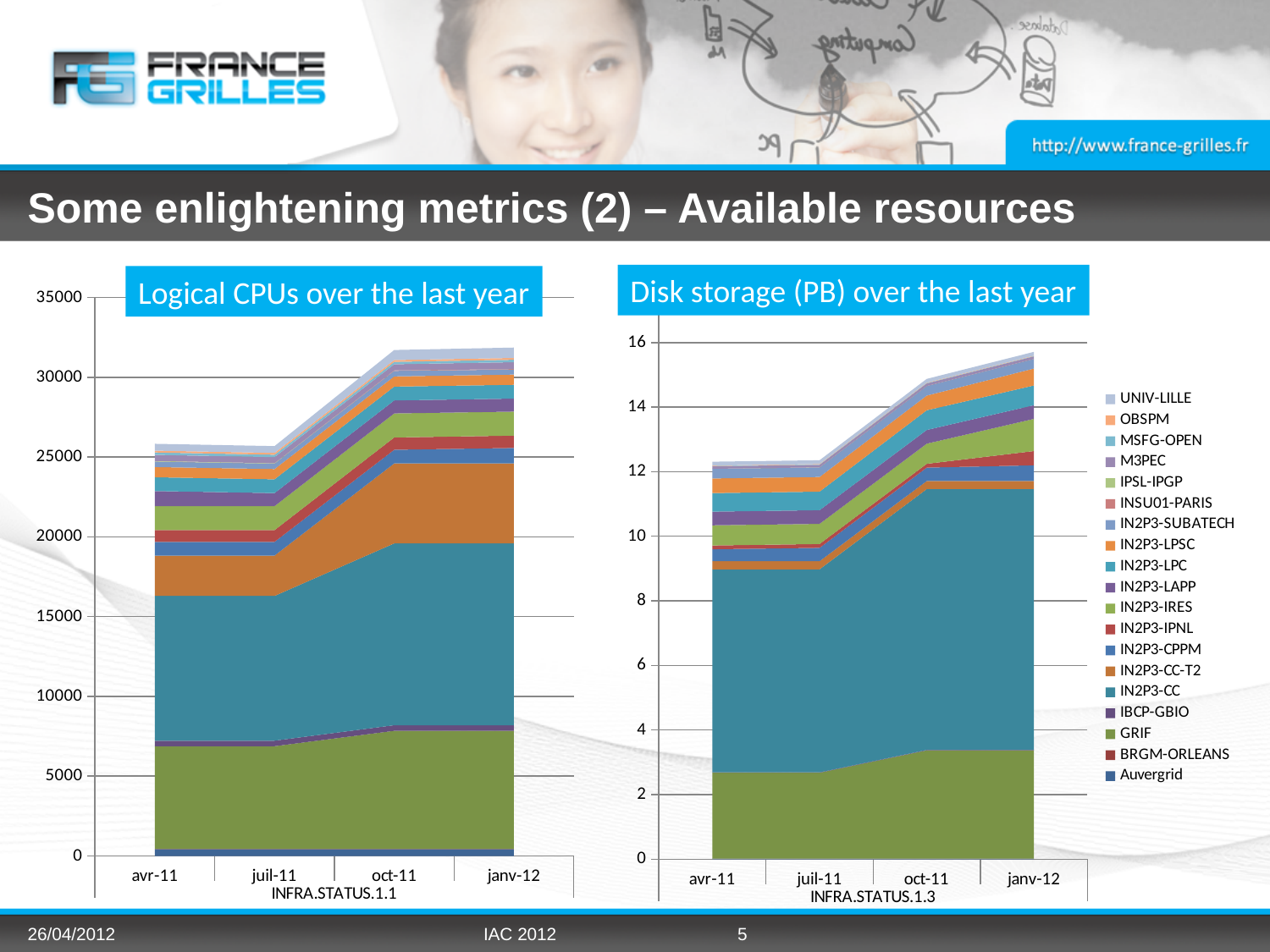
How many time points are shown on the x axis of the 'Logical CPUs over the last year' chart? 4 In the 'Logical CPUs over the last year' chart, does the total stacked value rise or fall from avr-11 to janv-12? rise What is the last time point on the x axis of the 'Disk storage (PB) over the last year' chart? janv-12 In the 'Disk storage (PB) over the last year' chart, is the total stacked value at janv-12 greater or less than 14? greater How many series does the legend list for the 'Disk storage (PB) over the last year' chart? 19 In the 'Disk storage (PB) over the last year' chart, does the total stacked value rise or fall from juil-11 to janv-12? rise In the 'Logical CPUs over the last year' chart, is the total stacked value at janv-12 greater or less than 30000? greater What is the x-axis label shown beneath the time points of the 'Disk storage (PB) over the last year' chart? INFRA.STATUS.1.3 What kind of chart is the 'Logical CPUs over the last year' chart? stacked area chart In the 'Logical CPUs over the last year' chart, is the total stacked value at juil-11 greater or less than 30000? less What is the title of the chart on the left of the slide? Logical CPUs over the last year